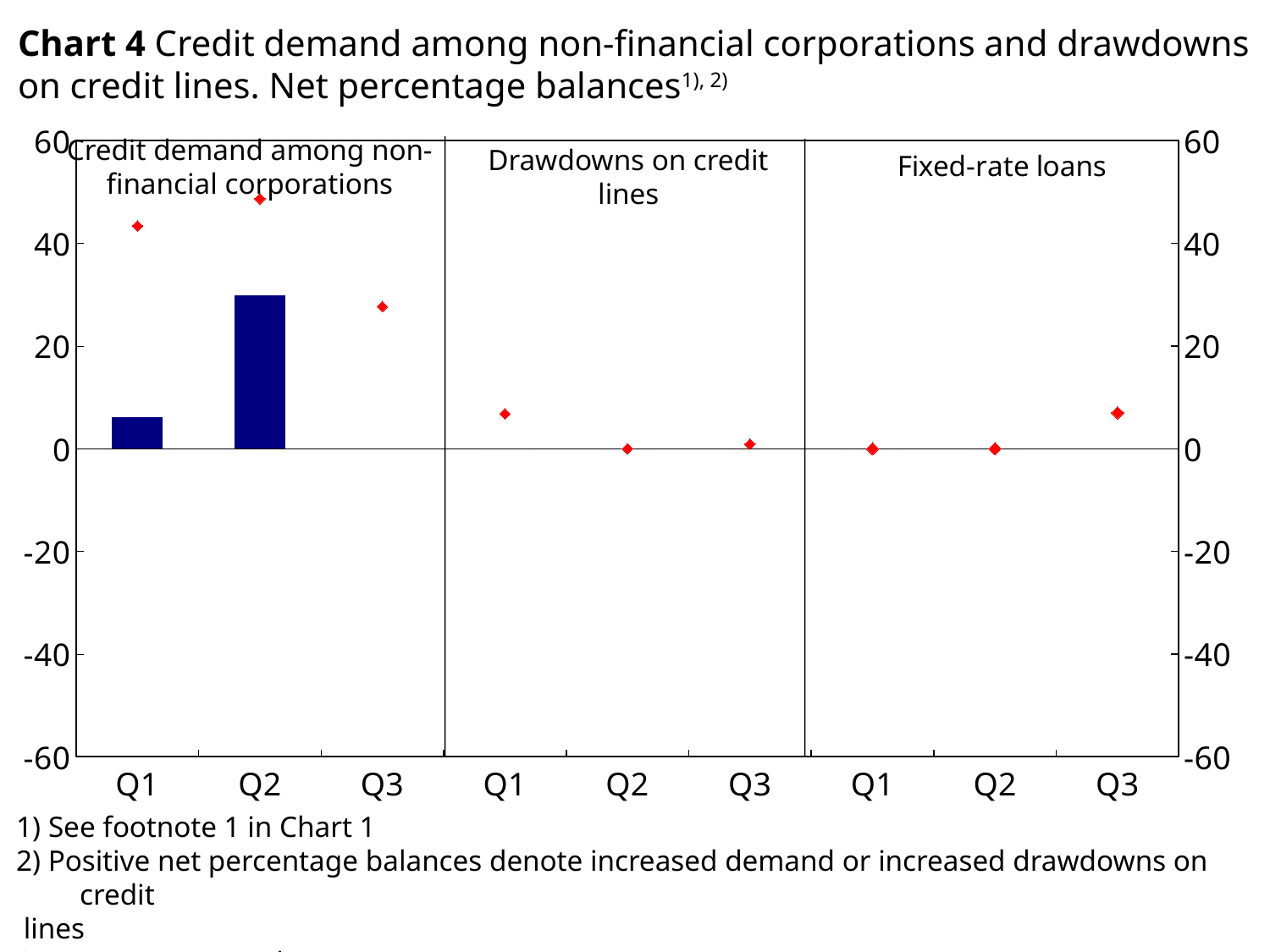
In the 'Credit demand among non-financial corporations' panel, which quarter has the highest red marker? Q2 In the 'Credit demand among non-financial corporations' panel, is the Q2 bar greater or less than 20? greater What is the title of the rightmost panel of the chart? Fixed-rate loans In the 'Credit demand among non-financial corporations' panel, is the red marker for Q3 greater or less than 40? less In the 'Fixed-rate loans' panel, which quarter has the highest red marker? Q3 In the 'Credit demand among non-financial corporations' panel, is the Q1 bar greater or less than 20? less In the 'Drawdowns on credit lines' panel, which quarter has the highest red marker? Q1 How many quarters are shown on the x axis of each panel? 3 How many panels does the chart contain? 3 In the 'Credit demand among non-financial corporations' panel, which quarter has the taller bar, Q1 or Q2? Q2